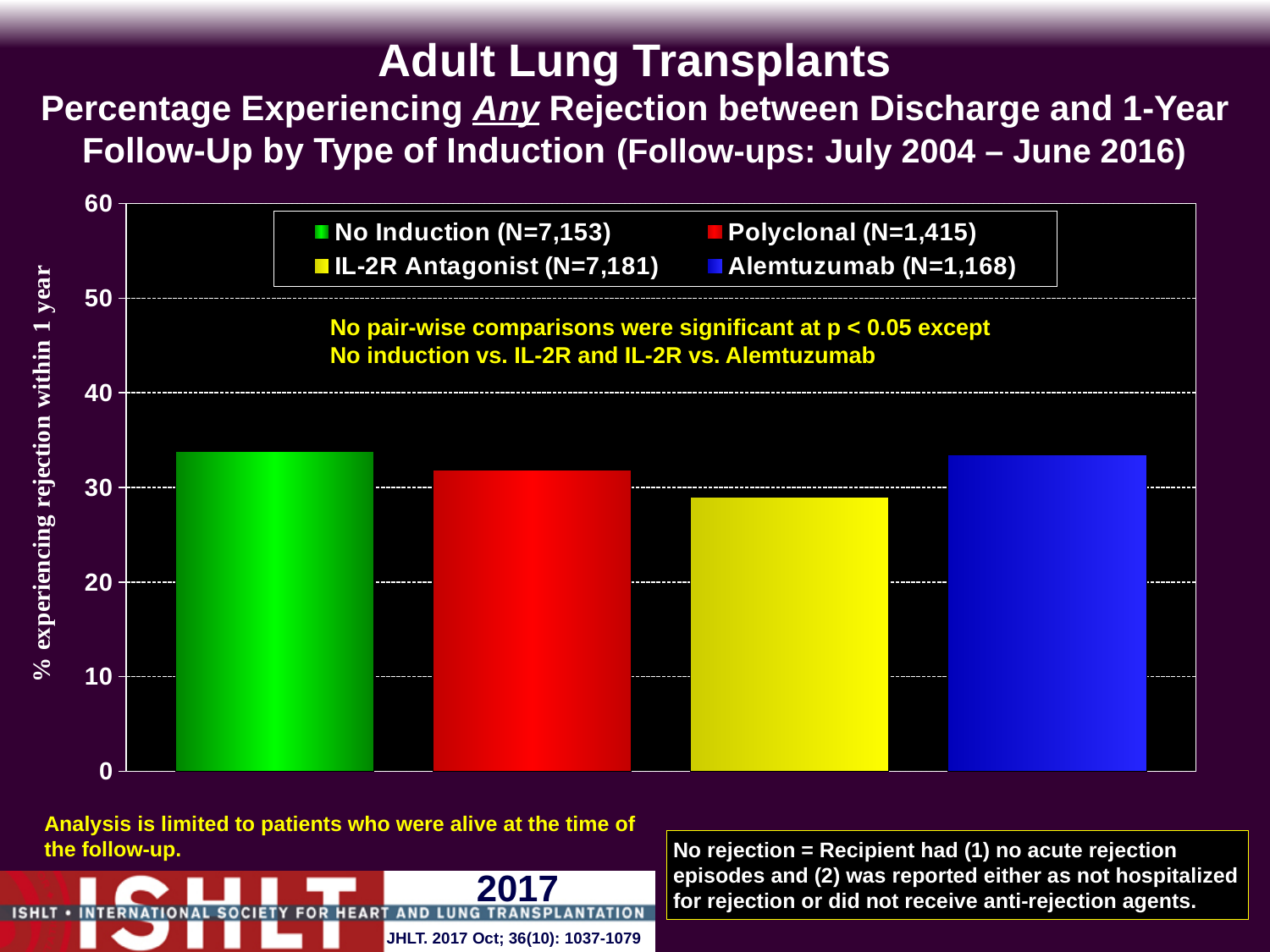
Is the value for IL-2R Antagonist greater or less than 30? less How many bars are plotted in the chart? 4 How many series does the legend list? 4 What colour is the bar for IL-2R Antagonist? yellow What is the N given in the legend for Polyclonal? 1,415 Is the value for Polyclonal greater or less than 30? greater Is the value for No Induction greater or less than 30? greater Which has a higher percentage experiencing rejection, Polyclonal or IL-2R Antagonist? Polyclonal Which has a higher percentage experiencing rejection, Alemtuzumab or IL-2R Antagonist? Alemtuzumab Which induction type has the lowest percentage experiencing rejection within 1 year? IL-2R Antagonist What kind of chart is shown on the slide? bar chart